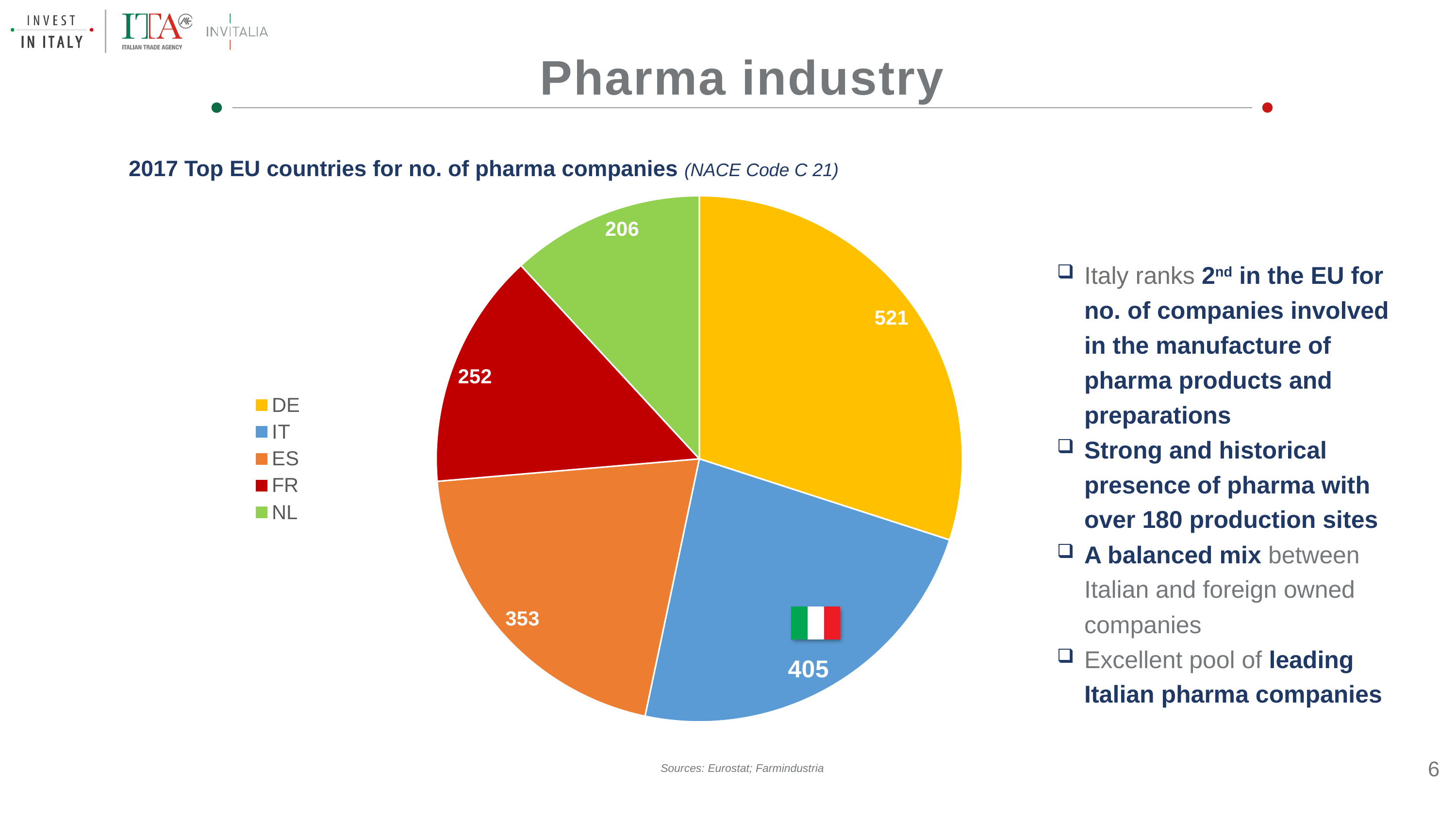
What type of chart is shown on the slide? pie chart What is the value shown for FR in the pie chart? 252 Which has a larger value in the pie chart, ES or FR? ES What is the difference between the values for DE and IT in the pie chart? 116 What colour is the slice for IT in the pie chart? blue Which country has the largest slice in the pie chart? DE What is the total of all values shown in the pie chart? 1737 What is the number of pharma companies for IT in the pie chart? 405 How many countries are shown in the pie chart? 5 What is the number of pharma companies for DE in the pie chart? 521 Which country has the smallest slice in the pie chart? NL How many entries does the legend of the pie chart list? 5